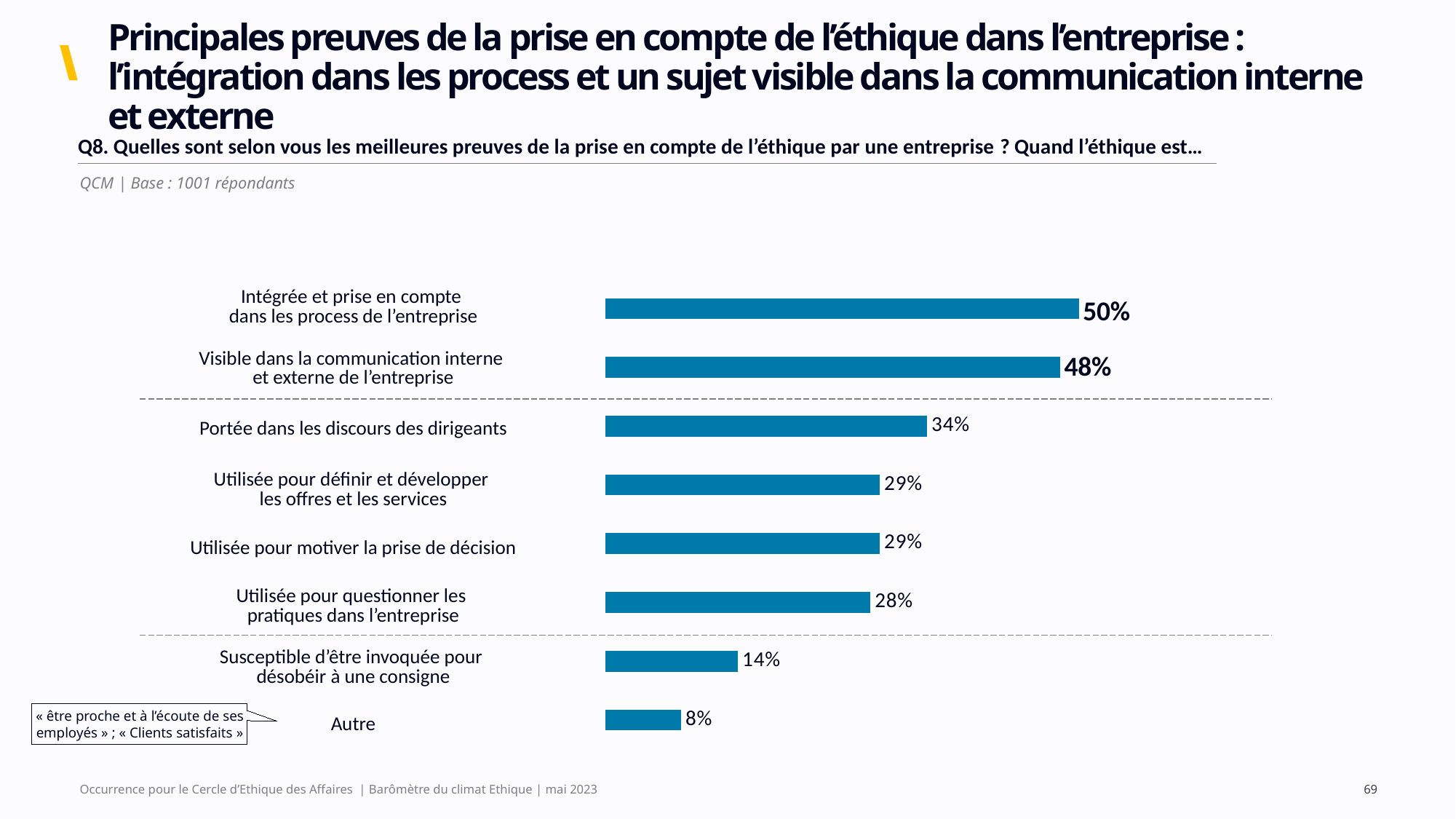
What is the value for "Autre"? 8% What is the value for "Intégrée et prise en compte dans les process de l'entreprise"? 50% What is the value for "Susceptible d'être invoquée pour désobéir à une consigne"? 14% Which category has the lowest value? Autre What is the base (number of respondents) stated for the chart? 1001 répondants Which category has the highest value? Intégrée et prise en compte dans les process de l'entreprise What is the value for "Portée dans les discours des dirigeants"? 34% What is the difference between "Intégrée et prise en compte dans les process de l'entreprise" and "Visible dans la communication interne et externe de l'entreprise"? 2 percentage points How many categories are shown in the chart? 8 What kind of chart is shown on the slide? Bar chart What is the difference between "Portée dans les discours des dirigeants" and "Utilisée pour questionner les pratiques dans l'entreprise"? 6 percentage points Which is larger: "Portée dans les discours des dirigeants" or "Utilisée pour motiver la prise de décision"? Portée dans les discours des dirigeants